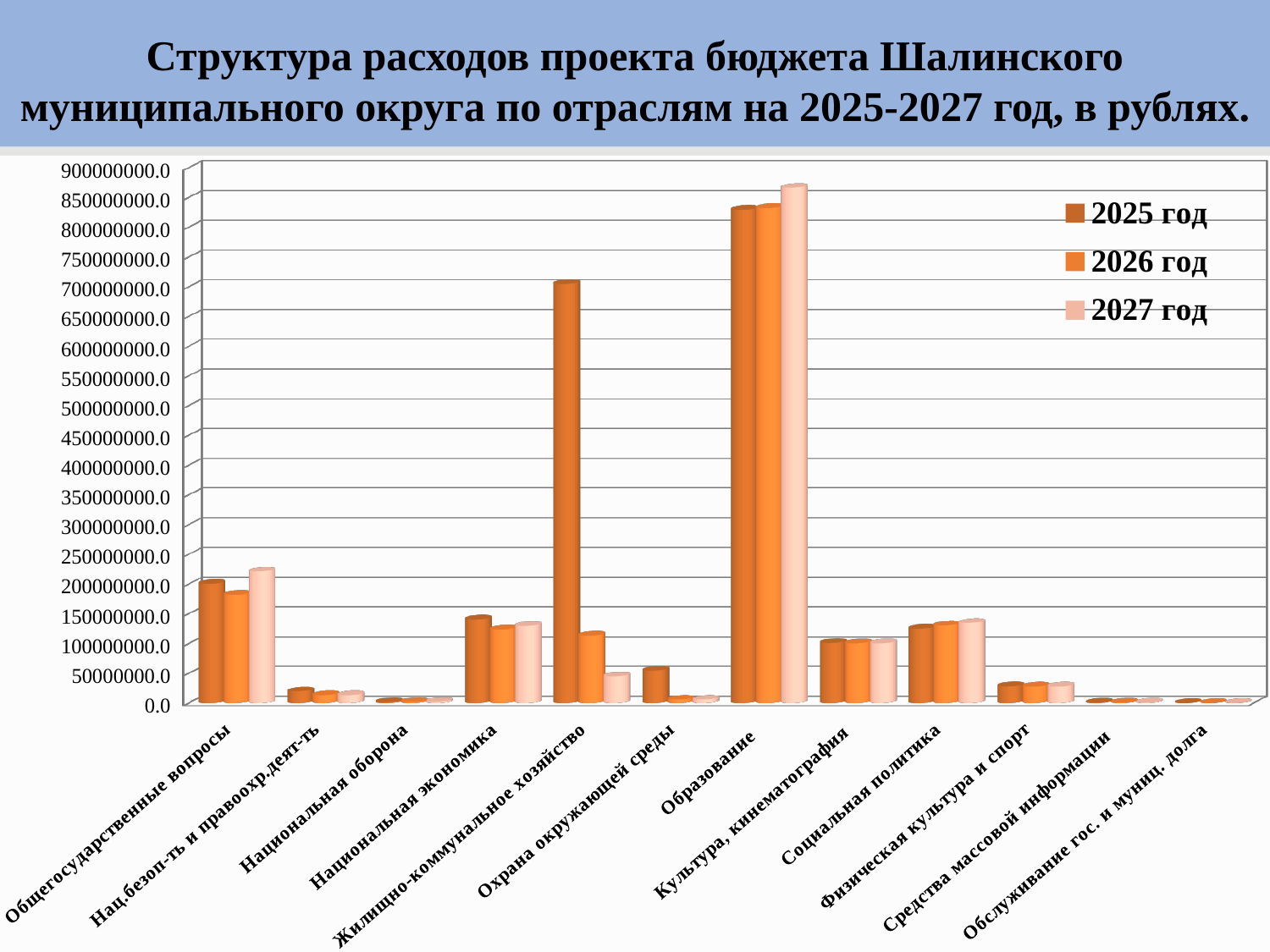
Is the 2025 год value for Жилищно-коммунальное хозяйство greater or less than 650000000.0? greater How many series does the legend list? 3 What kind of chart is shown on the slide? bar chart Which category has the highest value for the 2025 год series? Образование Is the 2027 год value for Общегосударственные вопросы greater or less than 200000000.0? greater For Жилищно-коммунальное хозяйство, which is larger: the 2025 год value or the 2026 год value? 2025 год What are the three entries listed in the legend? 2025 год, 2026 год, 2027 год Which category has the highest value for the 2027 год series? Образование Is the 2025 год value for Образование greater or less than 800000000.0? greater For Образование, do the values rise or fall from 2025 год to 2027 год? rise How many categories are shown along the x axis? 12